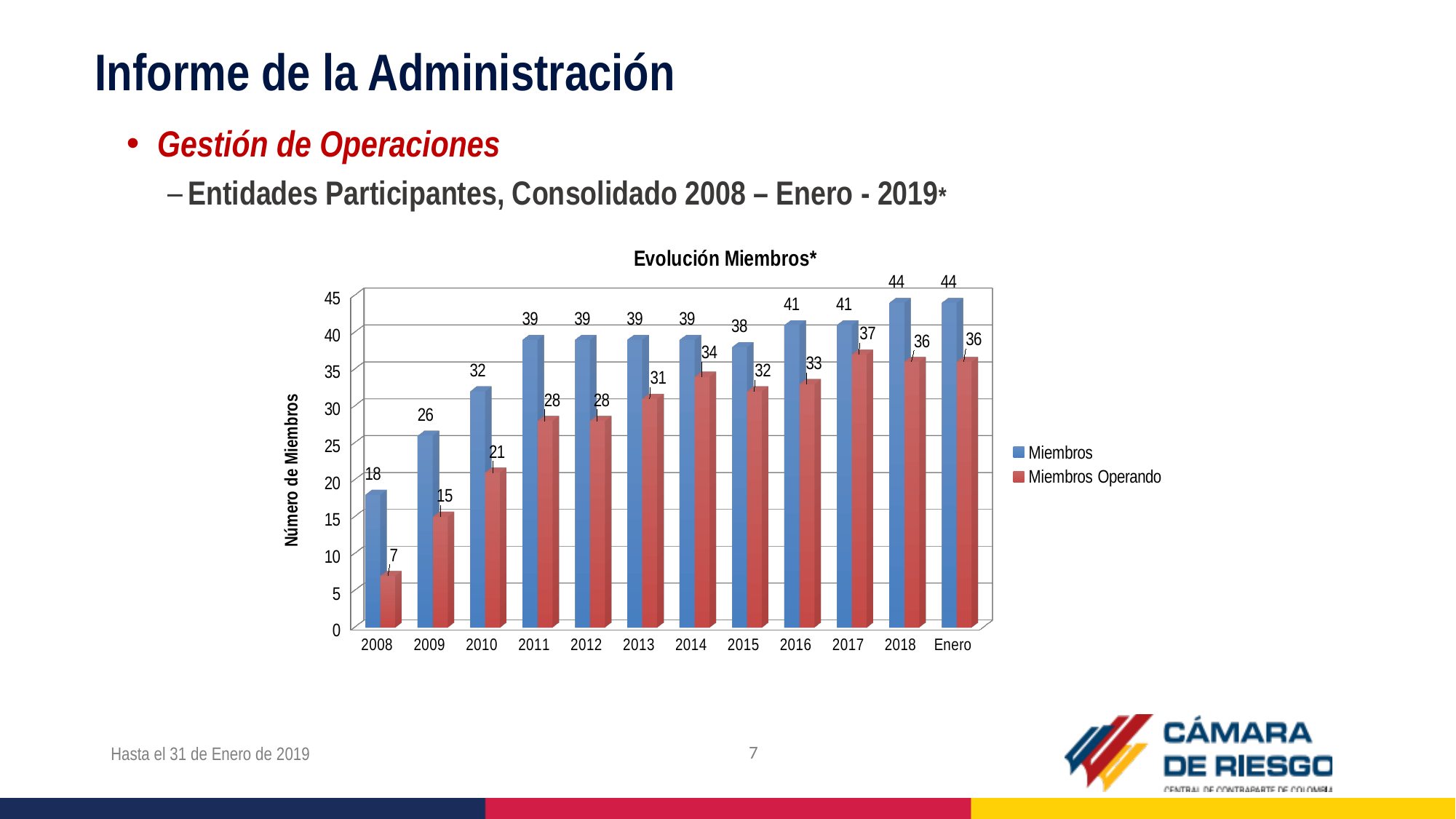
How many categories are shown on the x axis? 12 Which category has the highest value for Miembros Operando? 2017 What is the title of the chart? Evolución Miembros* What is the value of Miembros for 2010? 32 Which is larger: Miembros Operando in 2016 or Miembros Operando in 2013? Miembros Operando in 2016 What is the difference between Miembros and Miembros Operando in 2018? 8 Which category has the lowest value for Miembros? 2008 What is the value of Miembros Operando for 2008? 7 Do the Miembros Operando values generally rise or fall from 2008 to 2017? rise How many series does the legend list? 2 What is the value of Miembros Operando for 2014? 34 What kind of chart is shown? bar chart